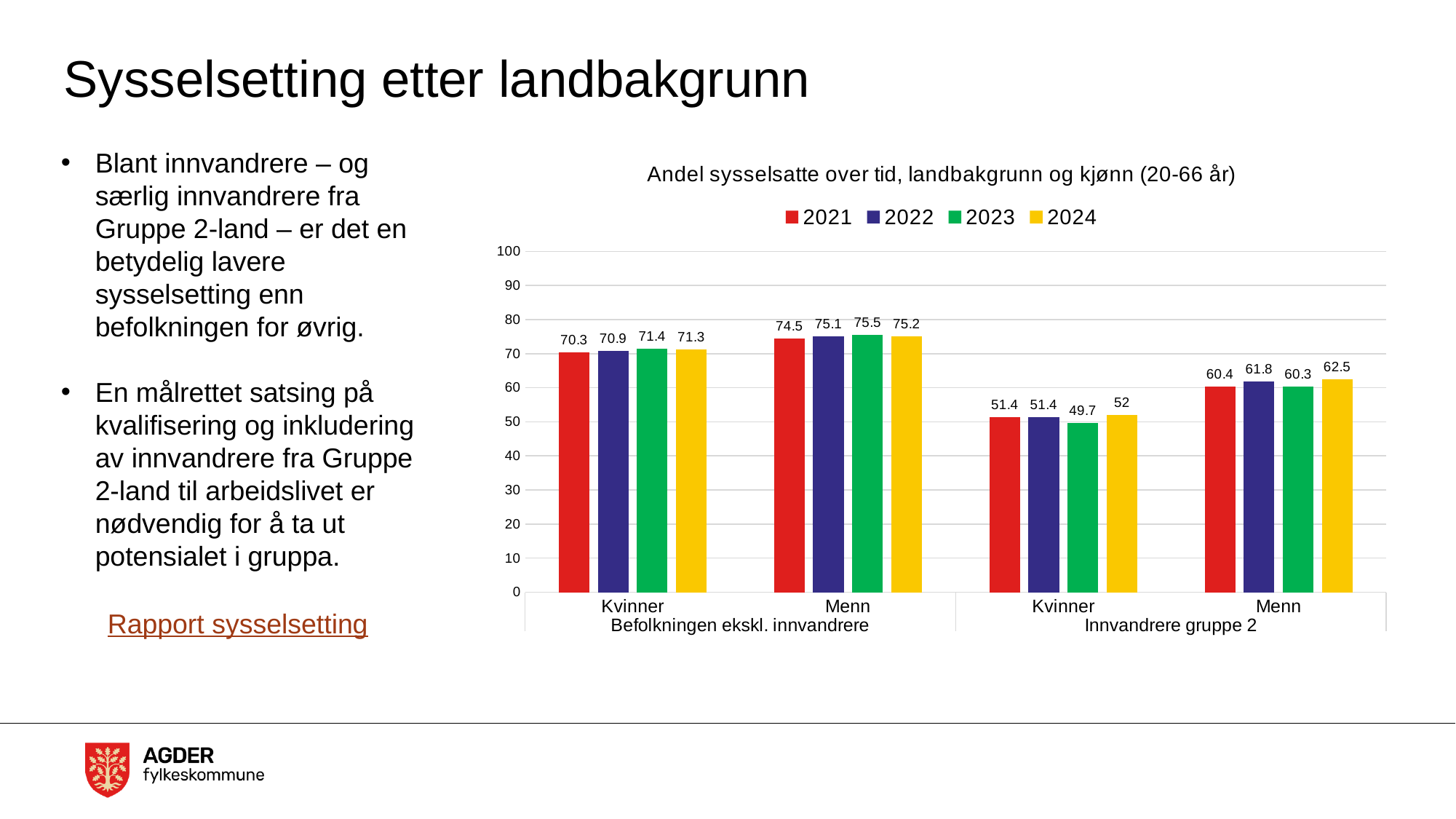
Is the 2022 value for Kvinner in the Innvandrere gruppe 2 group greater or less than 60? less How many series does the legend list? 4 Which year has the highest value for Menn in the Innvandrere gruppe 2 group? 2024 Which is larger: the 2023 value for Kvinner in Befolkningen ekskl. innvandrere or the 2023 value for Menn in Innvandrere gruppe 2? Kvinner in Befolkningen ekskl. innvandrere What is the 2022 value for Menn in the Befolkningen ekskl. innvandrere group? 75.1 What is the title of the chart? Andel sysselsatte over tid, landbakgrunn og kjønn (20-66 år) What is the 2023 value for Kvinner in the Innvandrere gruppe 2 group? 49.7 What is the difference between the 2024 values for Menn in Befolkningen ekskl. innvandrere and Menn in Innvandrere gruppe 2? 12.7 What is the 2021 value for Kvinner in the Befolkningen ekskl. innvandrere group? 70.3 Which year has the lowest value for Kvinner in the Innvandrere gruppe 2 group? 2023 What kind of chart is shown on the slide? bar chart What is the 2024 value for Menn in the Innvandrere gruppe 2 group? 62.5